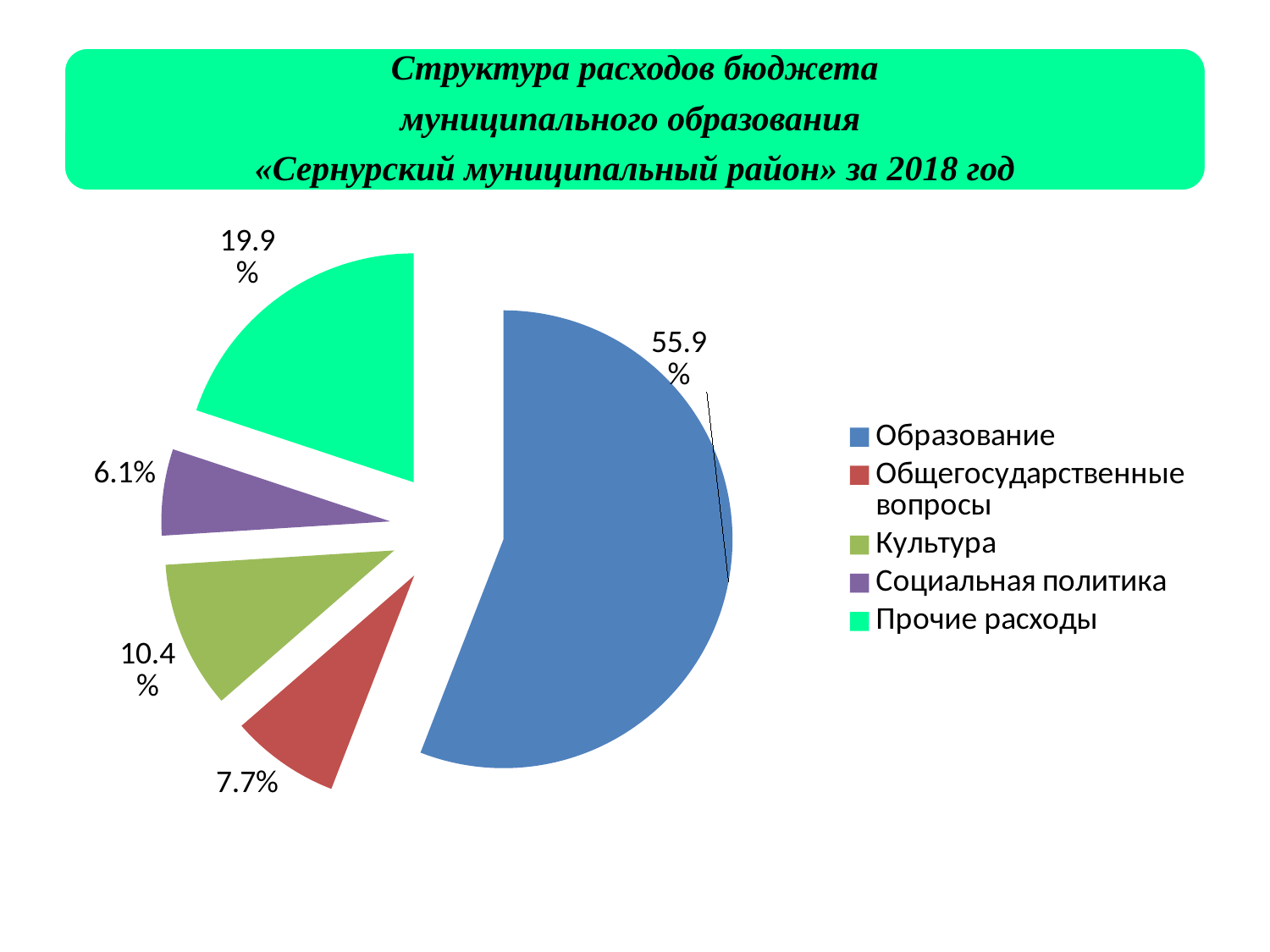
What share of the pie does Социальная политика have? 6.1% What share of the pie does Культура have? 10.4% What colour is the slice for Прочие расходы? Green Which category has the smallest share of the pie? Социальная политика How many categories does the pie chart show? 5 Which category has the largest share of the pie? Образование What share of the pie does Образование have? 55.9% What is the difference in percentage points between Прочие расходы and Культура? 9.5 What kind of chart is shown on the slide? Pie chart What share of the pie does Прочие расходы have? 19.9% Which is larger, the share for Культура or the share for Общегосударственные вопросы? Культура What share of the pie does Общегосударственные вопросы have? 7.7%